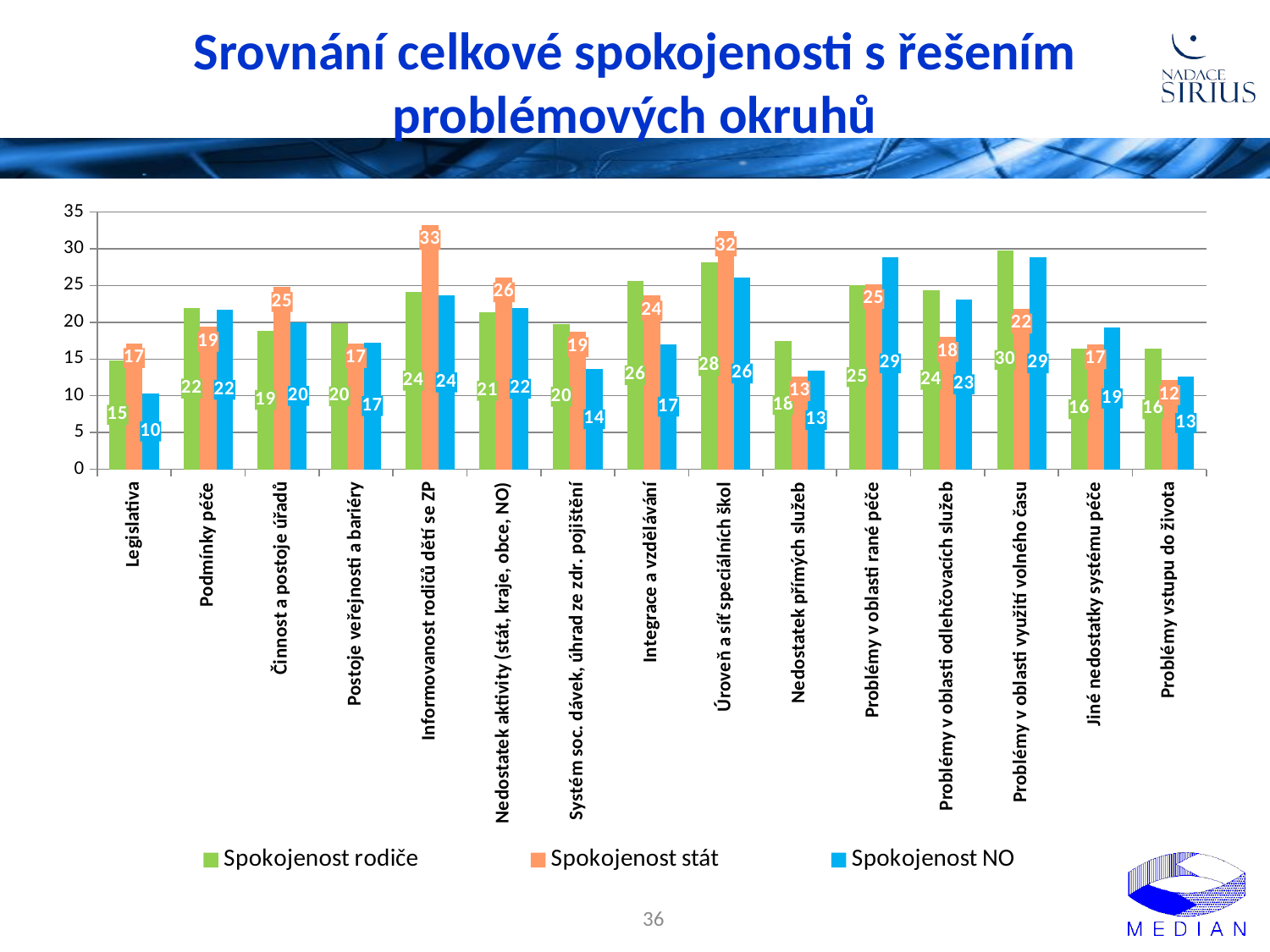
Which category has the highest value for Spokojenost rodiče? Problémy v oblasti využití volného času Which category has the lowest value for Spokojenost NO? Legislativa What type of chart is shown on the slide? bar chart Which category has the highest value for Spokojenost stát? Informovanost rodičů dětí se ZP How many categories are shown on the x axis? 15 How many series does the legend list? 3 What is the value of Spokojenost NO for Legislativa? 10 What is the value of Spokojenost rodiče for Úroveň a síť speciálních škol? 28 For Integrace a vzdělávání, which is larger: Spokojenost rodiče or Spokojenost NO? Spokojenost rodiče What is the value of Spokojenost stát for Informovanost rodičů dětí se ZP? 33 What is the difference between Spokojenost stát and Spokojenost rodiče for Činnost a postoje úřadů? 6 Which series is shown in orange in the legend? Spokojenost stát